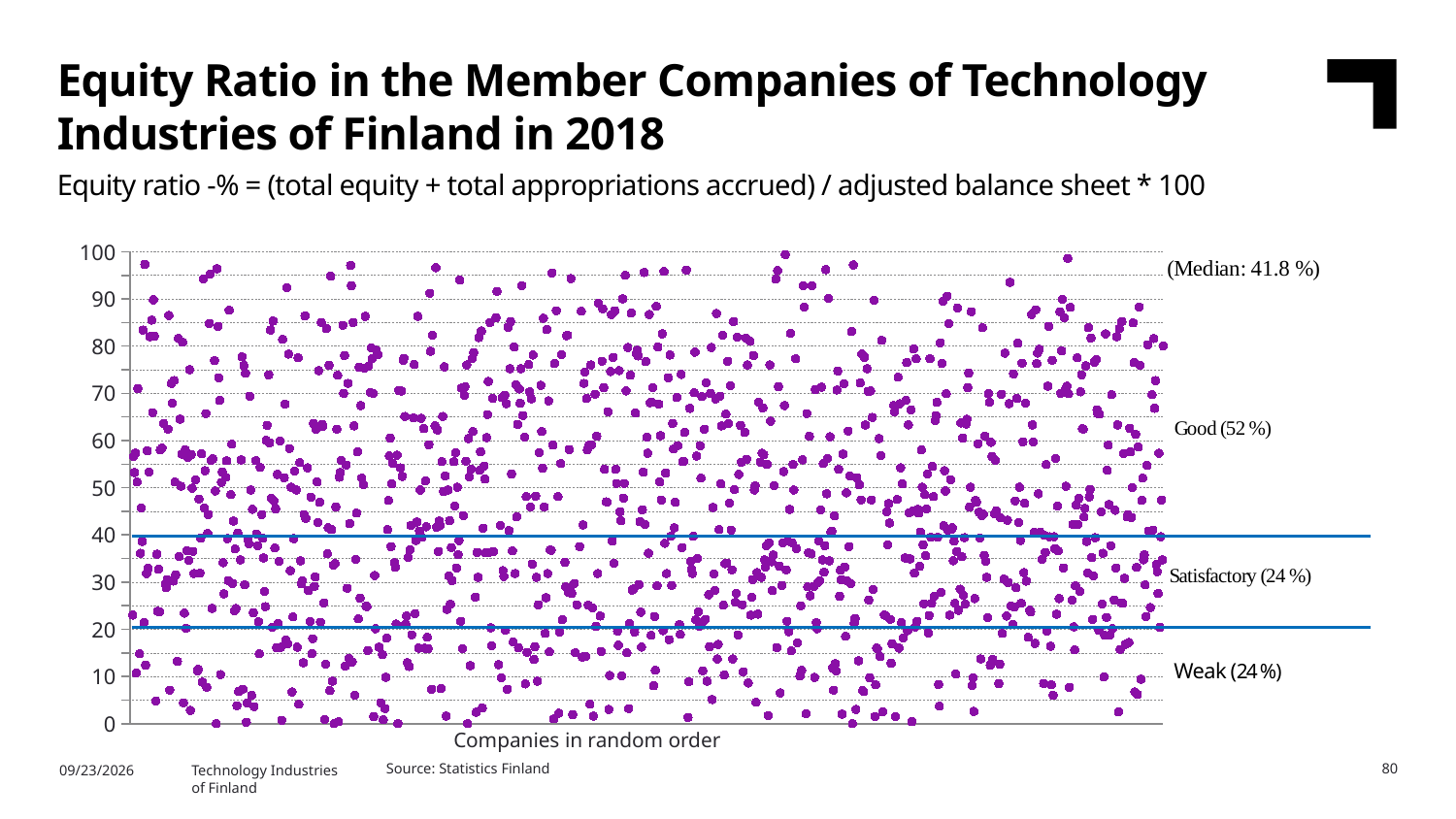
What is the difference between the share of Good companies and the share of Satisfactory companies? 28 % Which group (Good, Satisfactory or Weak) has the largest share of companies? Good What is the highest value shown on the y axis of the chart? 100 What share of companies is labelled as Weak on the chart? 24 % What is the label of the x axis of the chart? Companies in random order How many equity ratio groups (Good, Satisfactory, Weak) are labelled on the chart? 3 What share of companies is labelled as Good on the chart? 52 % What share of companies is labelled as Satisfactory on the chart? 24 % What kind of chart is shown on the slide? scatter chart Is the median equity ratio greater or less than 40? greater What is the median equity ratio shown on the chart? 41.8 % Is the share of companies in the Good group larger or smaller than the share in the Satisfactory group? larger